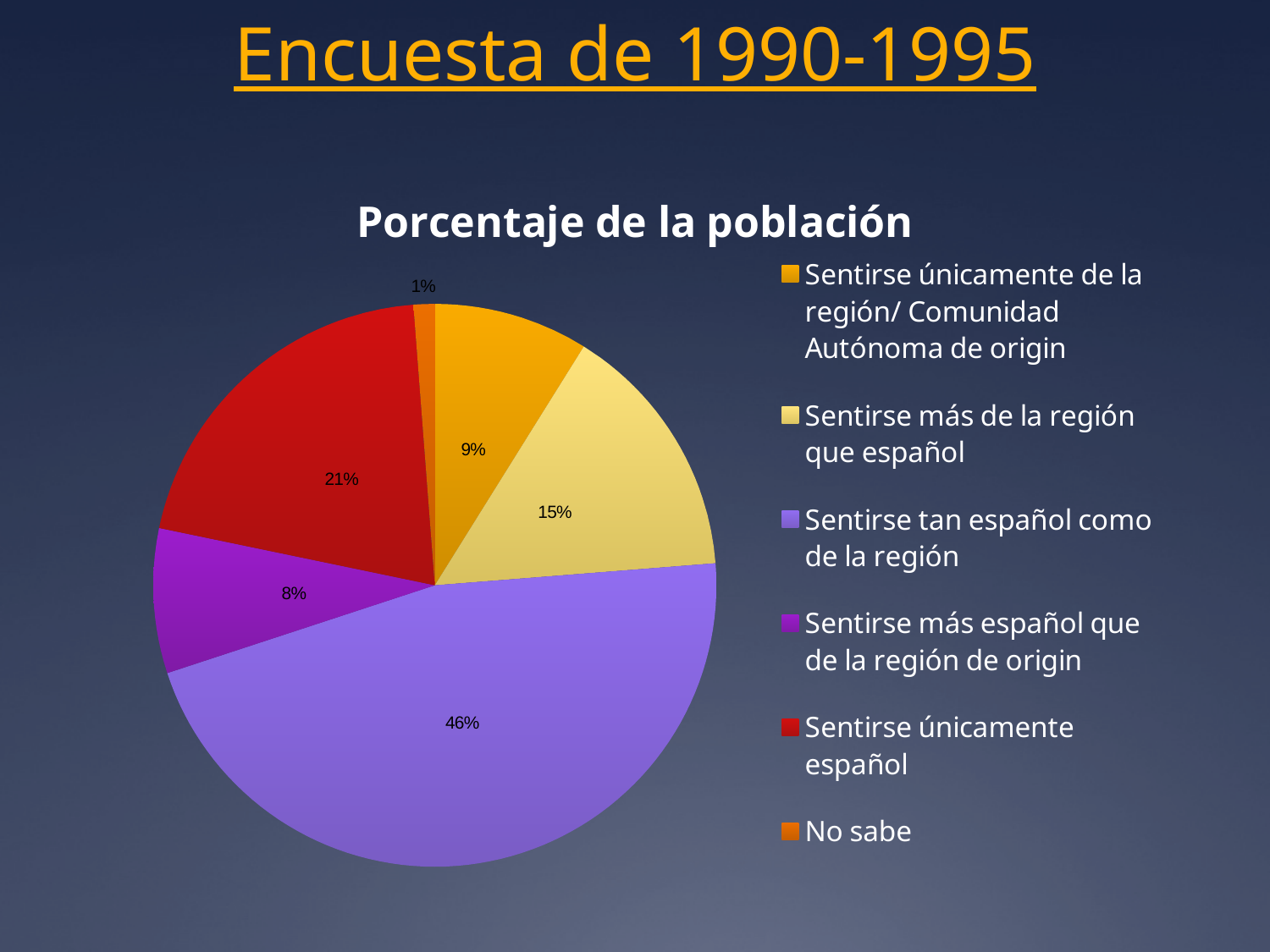
What is the title of the chart? Porcentaje de la población Which category has the largest share of the pie? Sentirse tan español como de la región What percentage is shown for 'No sabe'? 1% What percentage is shown for 'Sentirse más de la región que español'? 15% What percentage is shown for 'Sentirse únicamente español'? 21% Which is larger: the share for 'Sentirse más de la región que español' or the share for 'Sentirse únicamente de la región/ Comunidad Autónoma de origin'? Sentirse más de la región que español What is the difference between the share for 'Sentirse únicamente español' and the share for 'Sentirse más español que de la región de origin'? 13% What colour is the slice for 'Sentirse únicamente español'? red How many categories does the legend list? 6 Which category has the smallest share of the pie? No sabe What type of chart is shown on the slide? pie chart What percentage is shown for 'Sentirse tan español como de la región'? 46%